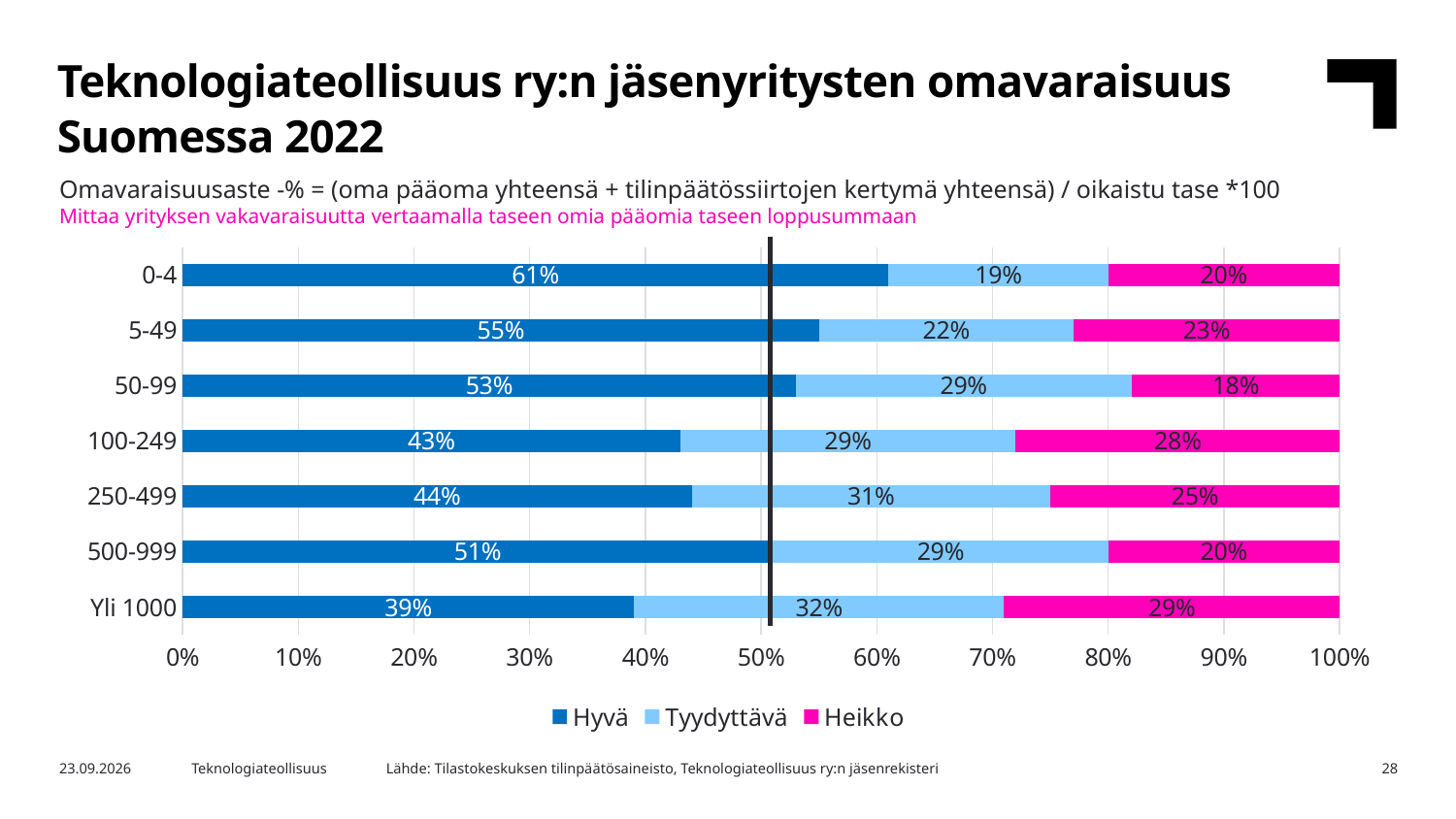
Which category has the lowest Hyvä share? Yli 1000 Which is larger: the Heikko share for 5-49 or the Heikko share for 250-499? 250-499 Which category has the lowest Heikko share? 50-99 How many series does the legend list? 3 What is the total of the stacked bar for the 500-999 category? 100% What is the difference between the Hyvä share for 5-49 and the Hyvä share for 50-99? 2 percentage points What kind of chart is shown on the slide? Stacked bar chart How many size categories are shown on the chart? 7 What is the Hyvä share for the 0-4 category? 61% What is the Tyydyttävä share for the Yli 1000 category? 32% What is the Heikko share for the 100-249 category? 28% Which category has the highest Hyvä share? 0-4